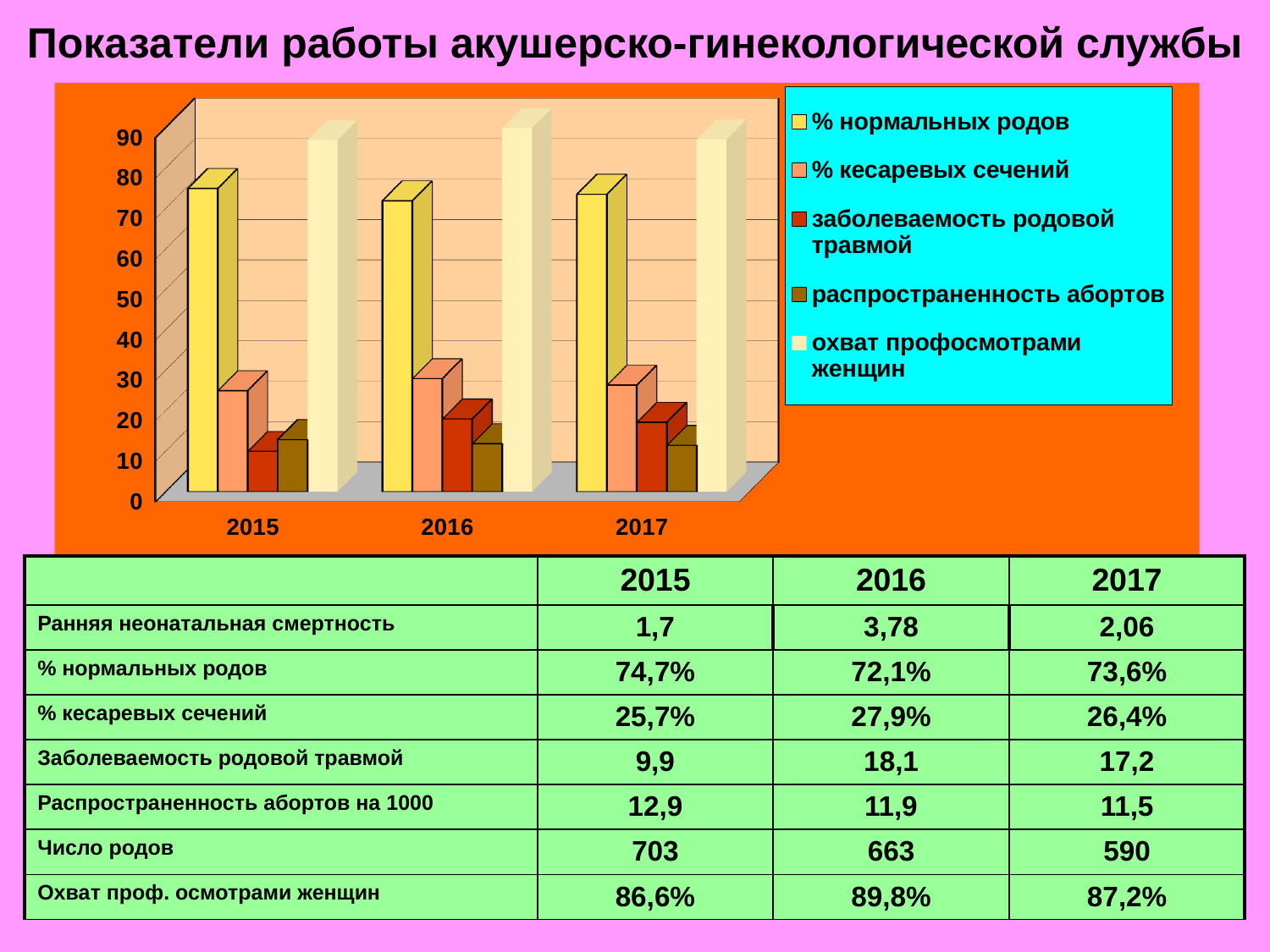
Which year has the larger value for % кесаревых сечений, 2016 or 2017? 2016 Which series has the highest bar for 2017? охват профосмотрами женщин What is the value of охват профосмотрами женщин for 2016? 89,8% What is the value of % нормальных родов for 2015? 74,7% Is the value for % нормальных родов in 2016 greater or less than 80? less What kind of chart is shown on the slide? bar chart Does распространенность абортов rise or fall from 2015 to 2017? fall Which series has the lowest bar for 2015? заболеваемость родовой травмой How many series does the chart legend list? 5 How many years are shown on the x axis of the chart? 3 Is the value for заболеваемость родовой травмой in 2015 greater or less than 20? less By how much did % кесаревых сечений change from 2015 to 2016? 2,2%